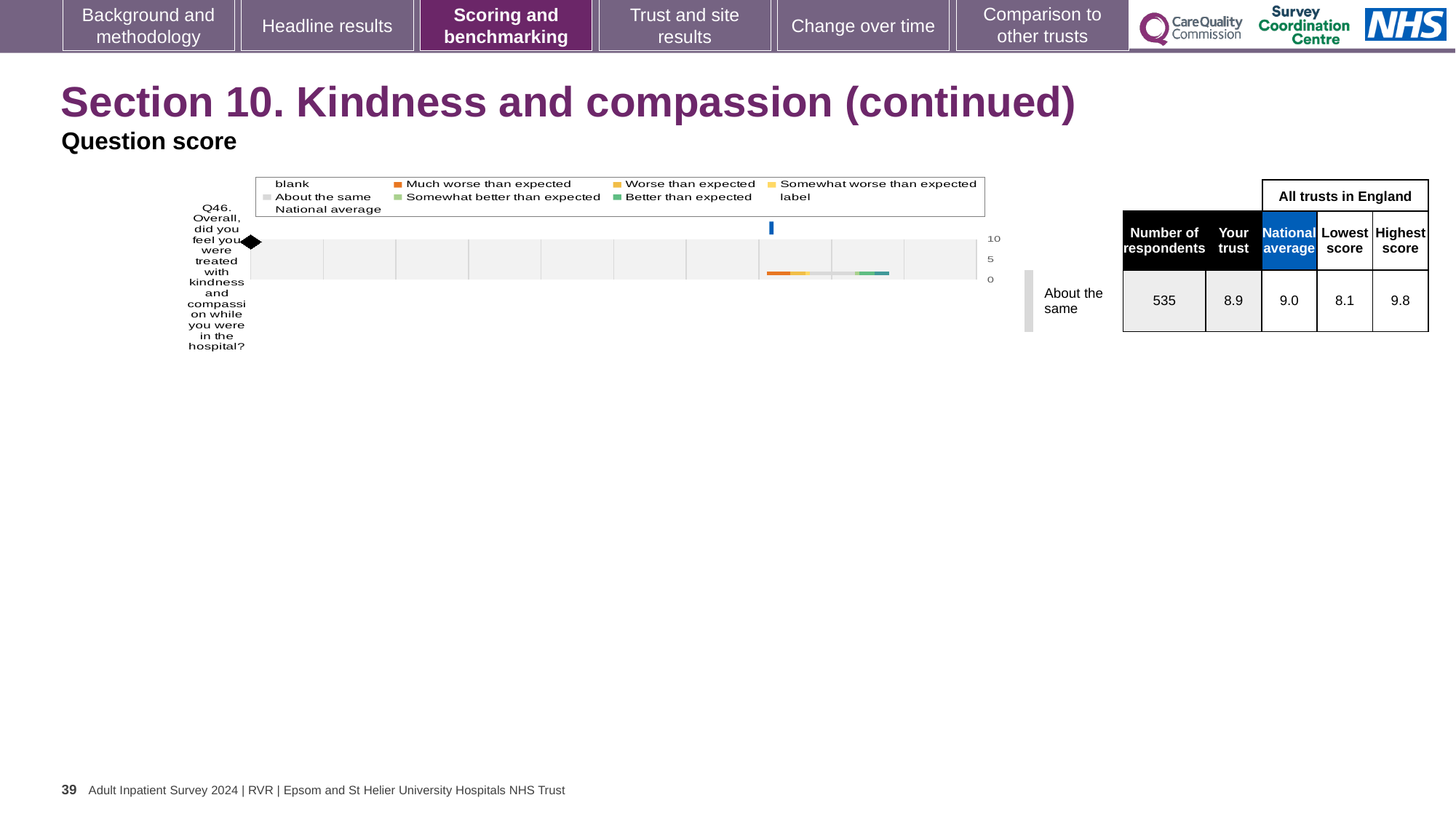
What is the 'Your trust' score for Q46 (treated with kindness and compassion)? 8.9 What is the lowest score among all trusts in England for Q46? 8.1 What is the difference between the highest and lowest scores across all trusts for Q46? 1.7 What is the highest score among all trusts in England for Q46? 9.8 What is the national average score for Q46? 9.0 By how much does the national average exceed the trust's score for Q46? 0.1 How many respondents answered Q46? 535 Which is larger for Q46: the trust's score or the national average? National average What kind of chart is used to show the Q46 score? Bar chart Which benchmark category is the trust's Q46 result placed in? About the same How many questions are plotted on the chart? 1